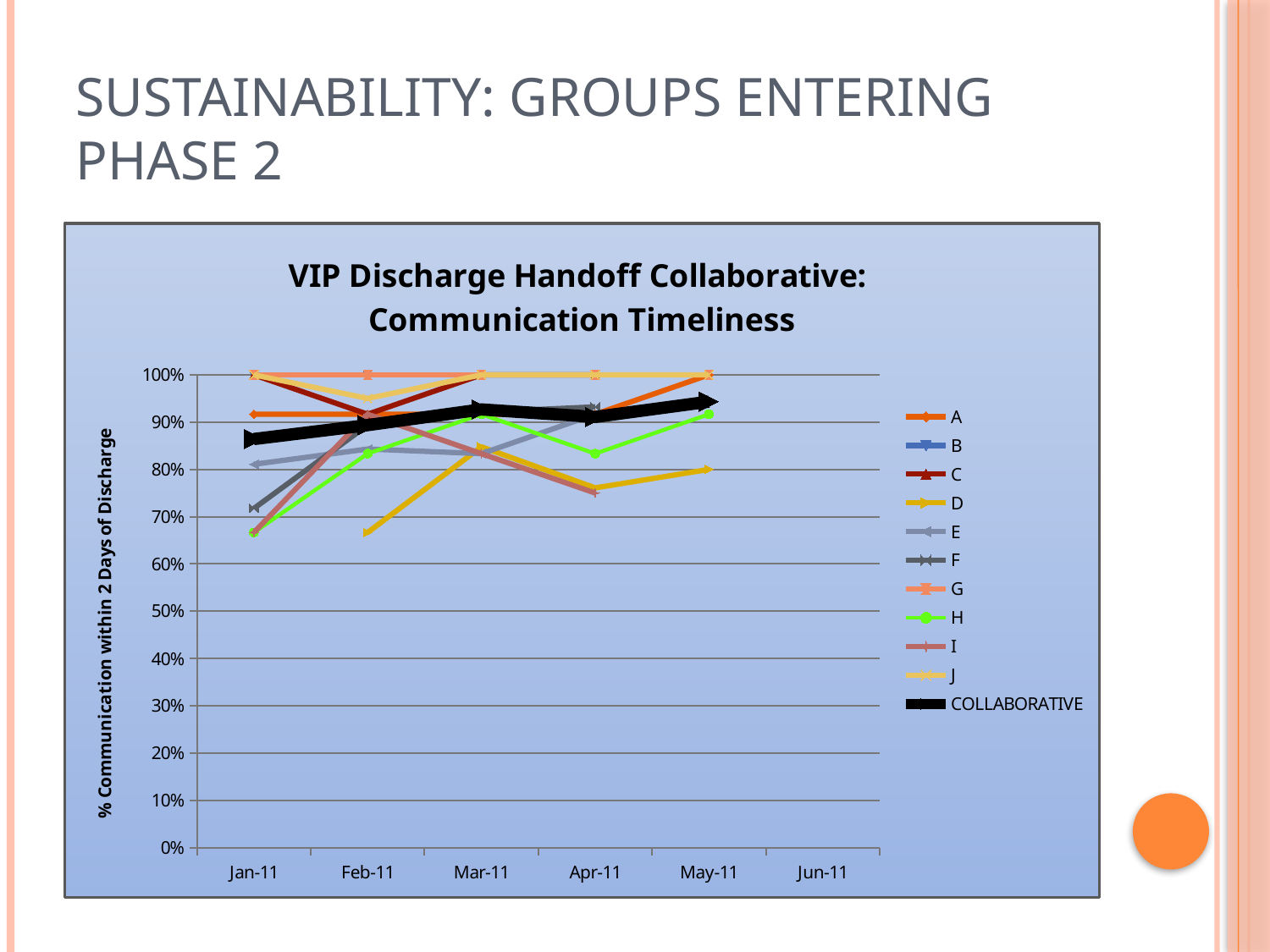
Is the value for COLLABORATIVE in Jan-11 greater or less than 80%? greater What is the label on the y axis? % Communication within 2 Days of Discharge How many series does the legend list? 11 What kind of chart is shown on the slide? line chart How many months are shown on the x axis? 6 Is the value for series D in Feb-11 greater or less than 70%? less What is the value for series G in Feb-11? 100% Is the value for series H in Jan-11 greater or less than 70%? less In Jan-11, which is larger, the value for series G or the value for series H? G Does the COLLABORATIVE line rise or fall from Jan-11 to May-11? rise What is the title of the chart? VIP Discharge Handoff Collaborative: Communication Timeliness